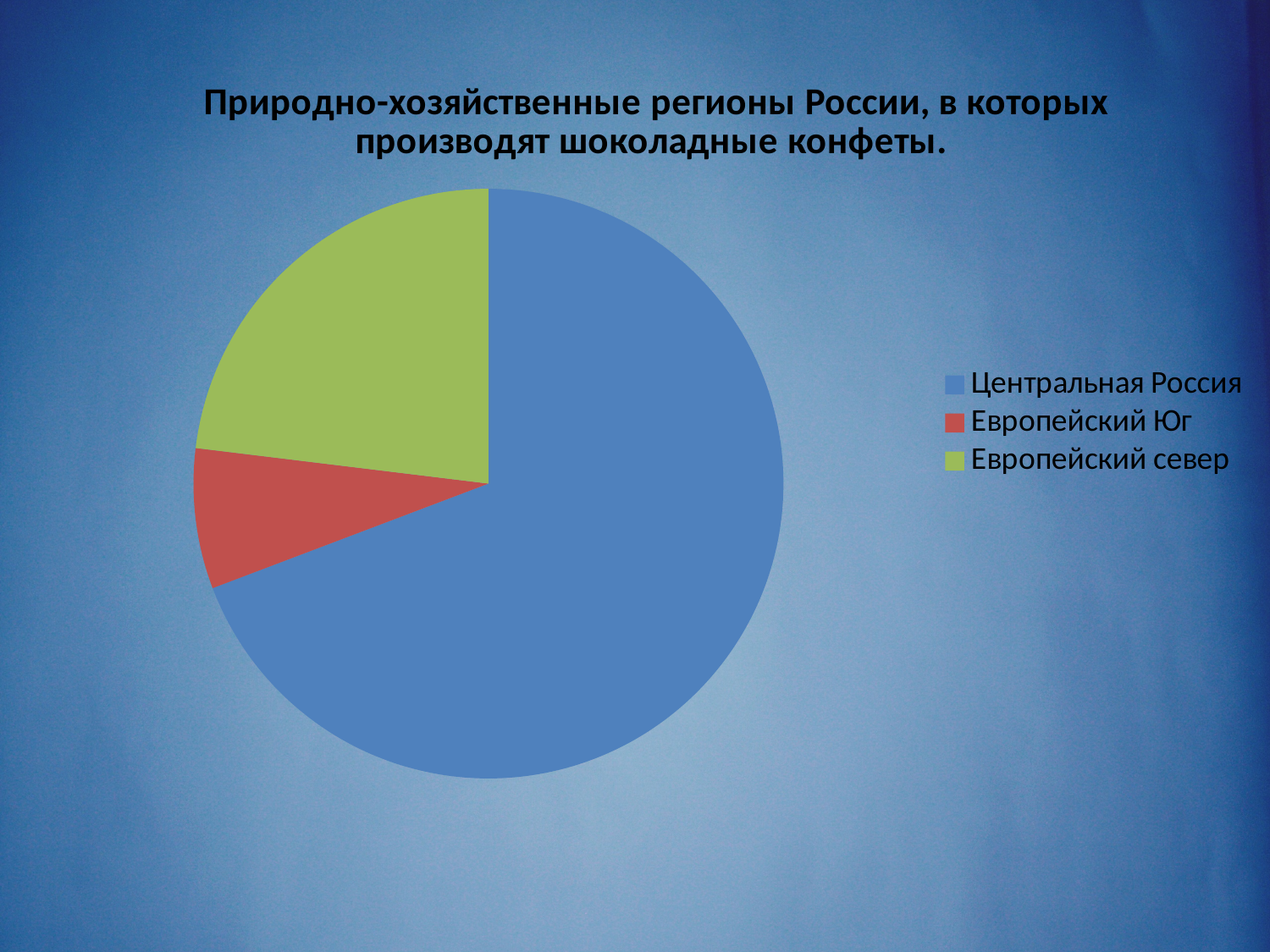
How many slices does the pie chart have? 3 Does Центральная Россия account for more or less than half of the pie chart? more Which slice is larger: Центральная Россия or Европейский север? Центральная Россия Which region has the smallest slice of the pie chart? Европейский Юг Which slice is larger: Европейский север or Европейский Юг? Европейский север How many entries does the legend of the pie chart list? 3 Which colour represents Европейский Юг in the pie chart? red Which region has the largest slice of the pie chart? Центральная Россия What is the title of the pie chart? Природно-хозяйственные регионы России, в которых производят шоколадные конфеты. What kind of chart is shown on the slide? pie chart